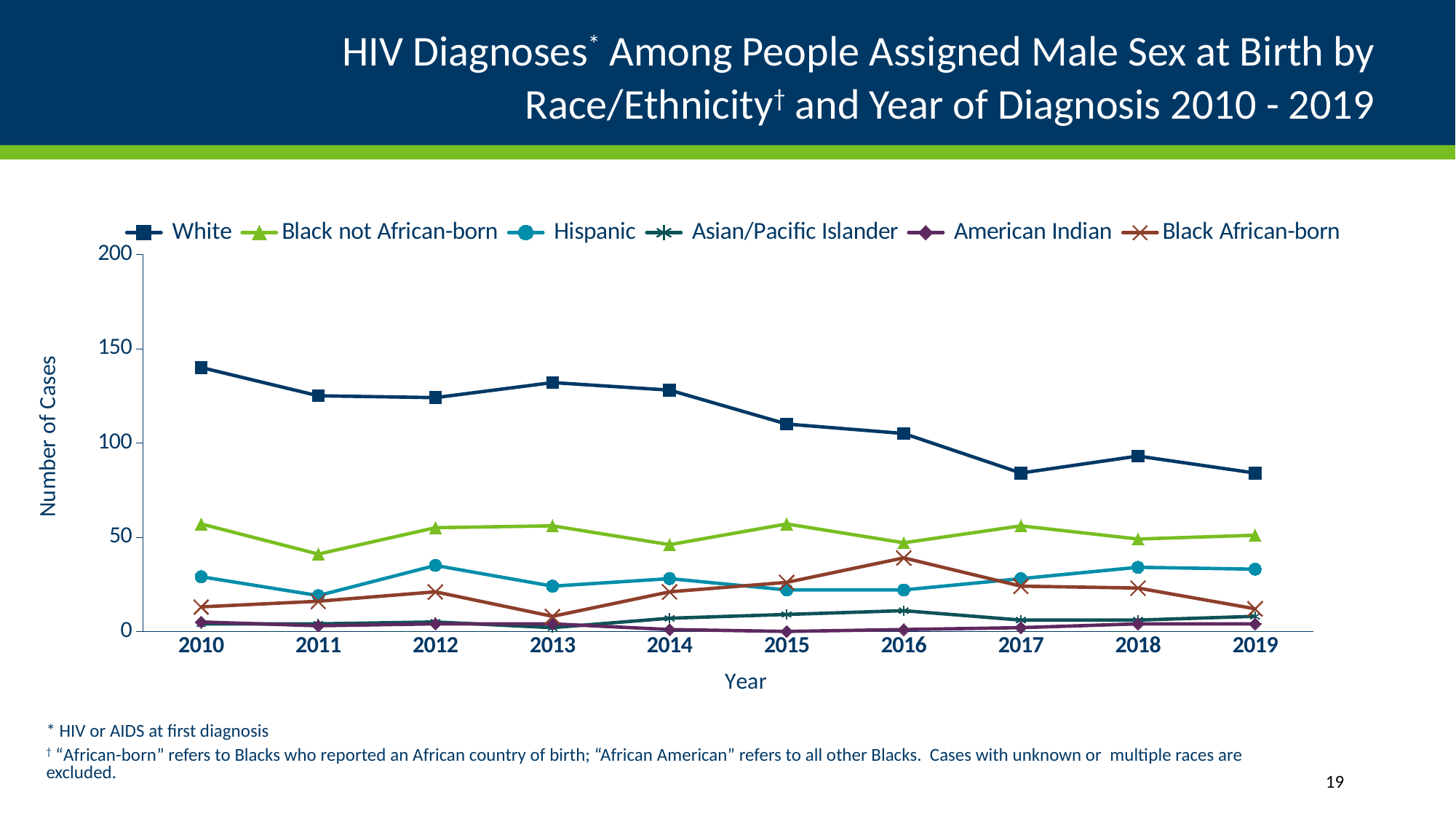
Is the value for White in 2017 greater or less than 100? less Does the number of cases for White rise or fall overall from 2010 to 2019? fall In which year is the value for White highest? 2010 What kind of chart is shown on the slide? line chart In 2016, which is larger: the value for Hispanic or the value for Black African-born? Black African-born Which series has the highest value in 2019? White What is the title of the y axis? Number of Cases How many years are plotted along the x axis? 10 Is the value for White in 2013 greater or less than 100? greater Is the value for Black not African-born in 2011 greater or less than 50? less How many series does the legend list? 6